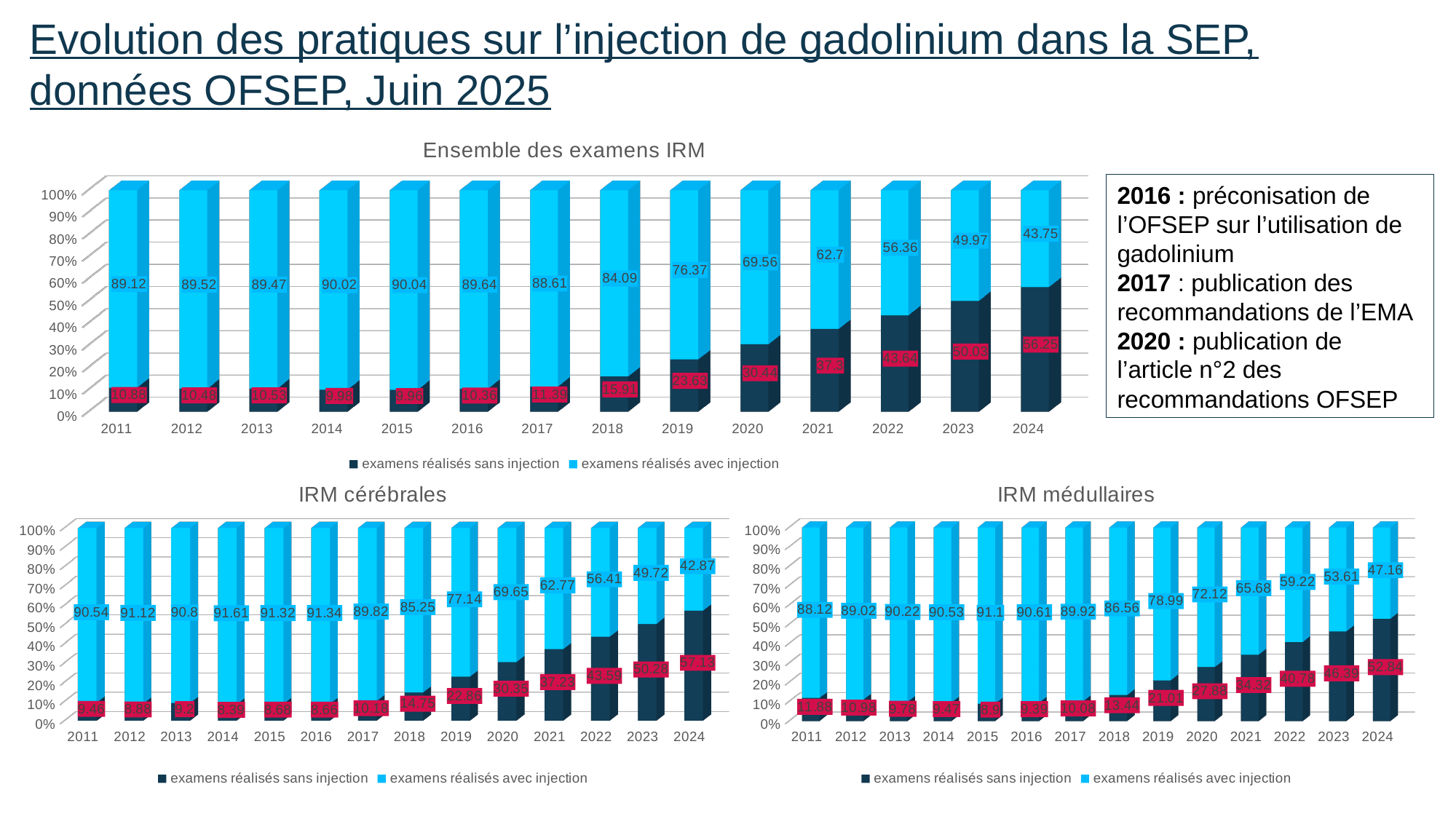
In the 'Ensemble des examens IRM' chart, does the value for 'examens réalisés avec injection' rise or fall from 2018 to 2024? Fall In the 'IRM cérébrales' chart, what is the value for 'examens réalisés avec injection' in 2021? 62.77 In the 'Ensemble des examens IRM' chart, which year has the highest value for 'examens réalisés sans injection'? 2024 In the 'IRM médullaires' chart, what is the value for 'examens réalisés avec injection' in 2024? 47.16 Which is larger in 2024: the 'examens réalisés sans injection' value in the 'IRM cérébrales' chart or in the 'IRM médullaires' chart? IRM cérébrales In the 'Ensemble des examens IRM' chart, what is the value for 'examens réalisés avec injection' in 2024? 43.75 In the 'IRM cérébrales' chart, how many series does the legend list? 2 What kind of chart is the 'IRM médullaires' chart? Stacked bar chart In the 'IRM cérébrales' chart, what is the value for 'examens réalisés sans injection' in 2024? 57.13 In the 'Ensemble des examens IRM' chart, what is the value for 'examens réalisés sans injection' in 2019? 23.63 In the 'Ensemble des examens IRM' chart, how many years are shown on the x axis? 14 In the 'Ensemble des examens IRM' chart, what is the difference between the 'examens réalisés avec injection' values for 2023 and 2024? 6.22